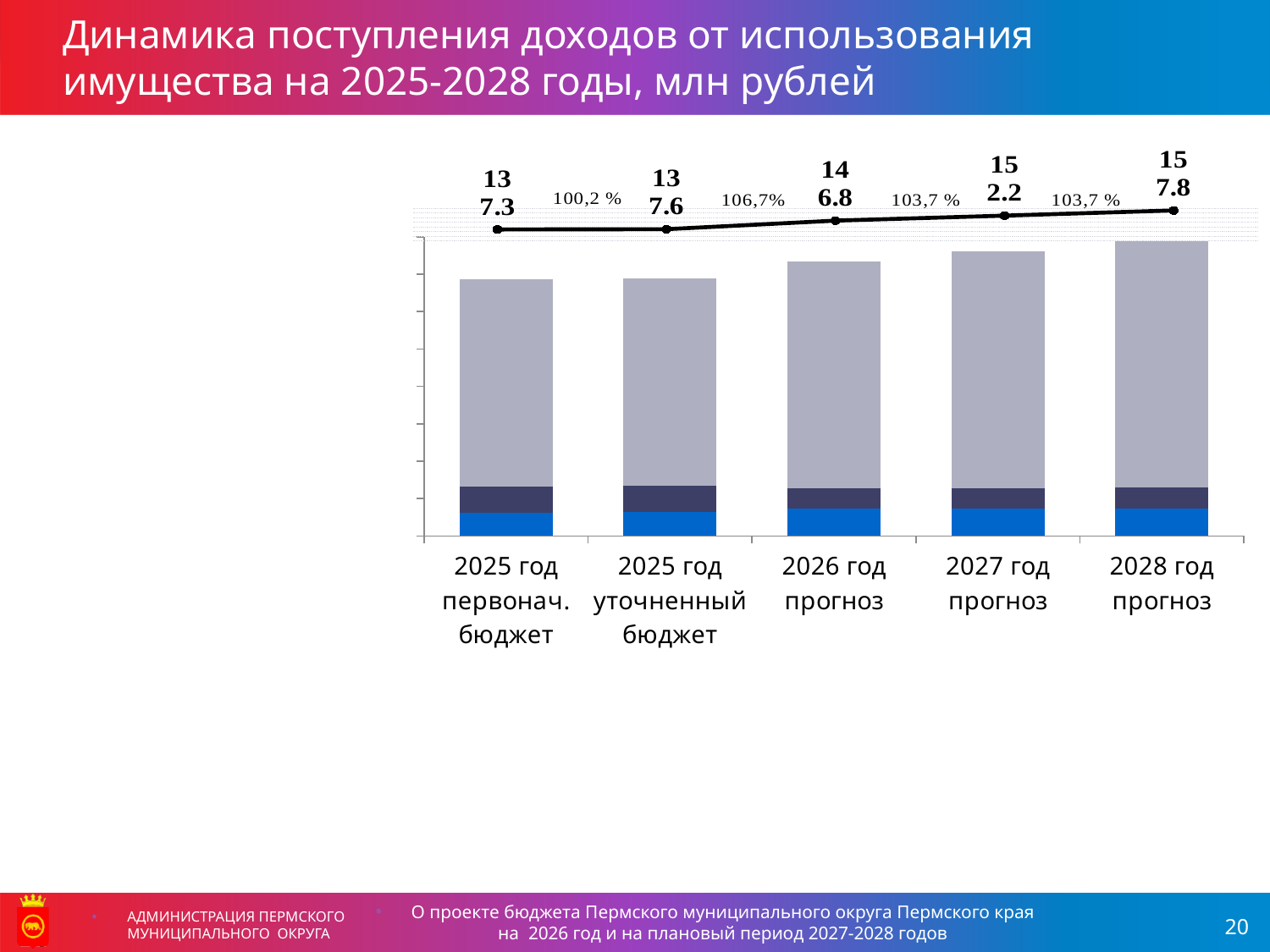
What is the value shown for 2025 год первонач. бюджет? 137.3 What percentage is shown between 2025 год уточненный бюджет and 2026 год прогноз? 106,7% What is the value shown for 2028 год прогноз? 157.8 What is the value shown for 2026 год прогноз? 146.8 What is the difference between the values for 2027 год прогноз and 2026 год прогноз? 5.4 Do the values rise or fall from left to right along the x axis? rise What is the value shown for 2027 год прогноз? 152.2 Which category has the highest value? 2028 год прогноз Which is larger, the value for 2025 год уточненный бюджет or the value for 2026 год прогноз? 2026 год прогноз Which category has the lowest value? 2025 год первонач. бюджет What is the difference between the values for 2028 год прогноз and 2025 год первонач. бюджет? 20.5 How many categories are shown on the x axis? 5